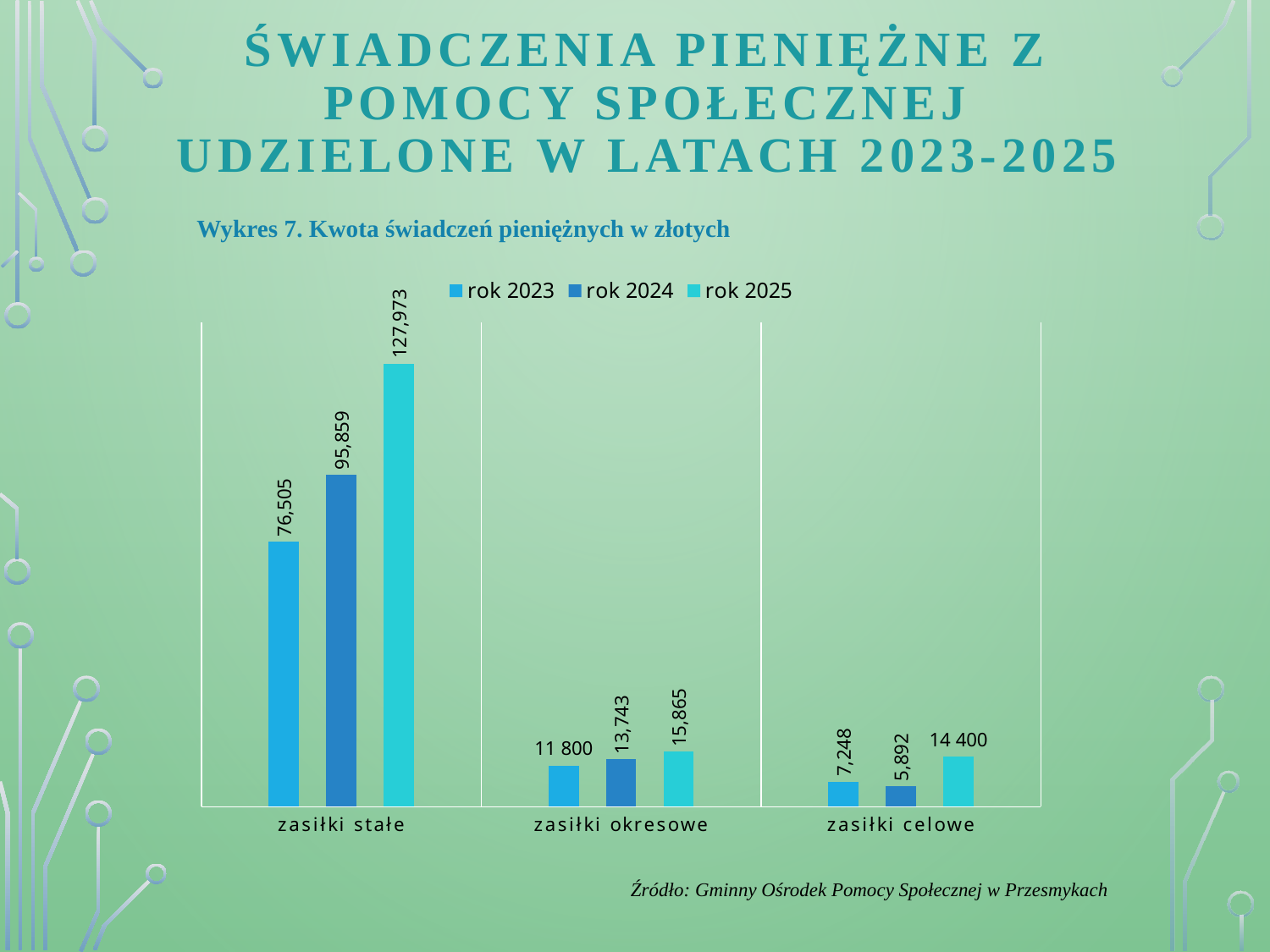
How many categories are shown on the x axis? 3 What is the value for zasiłki celowe in rok 2024? 5,892 What is the value for zasiłki stałe in rok 2025? 127,973 What is the value for zasiłki okresowe in rok 2023? 11 800 Which category has the lowest value in rok 2023? zasiłki celowe What is the difference between the rok 2025 and rok 2023 values for zasiłki stałe? 51,468 Which category has the highest value in rok 2024? zasiłki stałe How many series does the legend list? 3 Which is larger for zasiłki celowe: the rok 2023 value or the rok 2024 value? rok 2023 What kind of chart is shown on the slide? bar chart What is the value for zasiłki celowe in rok 2025? 14 400 What is the difference between the rok 2025 and rok 2024 values for zasiłki okresowe? 2,122